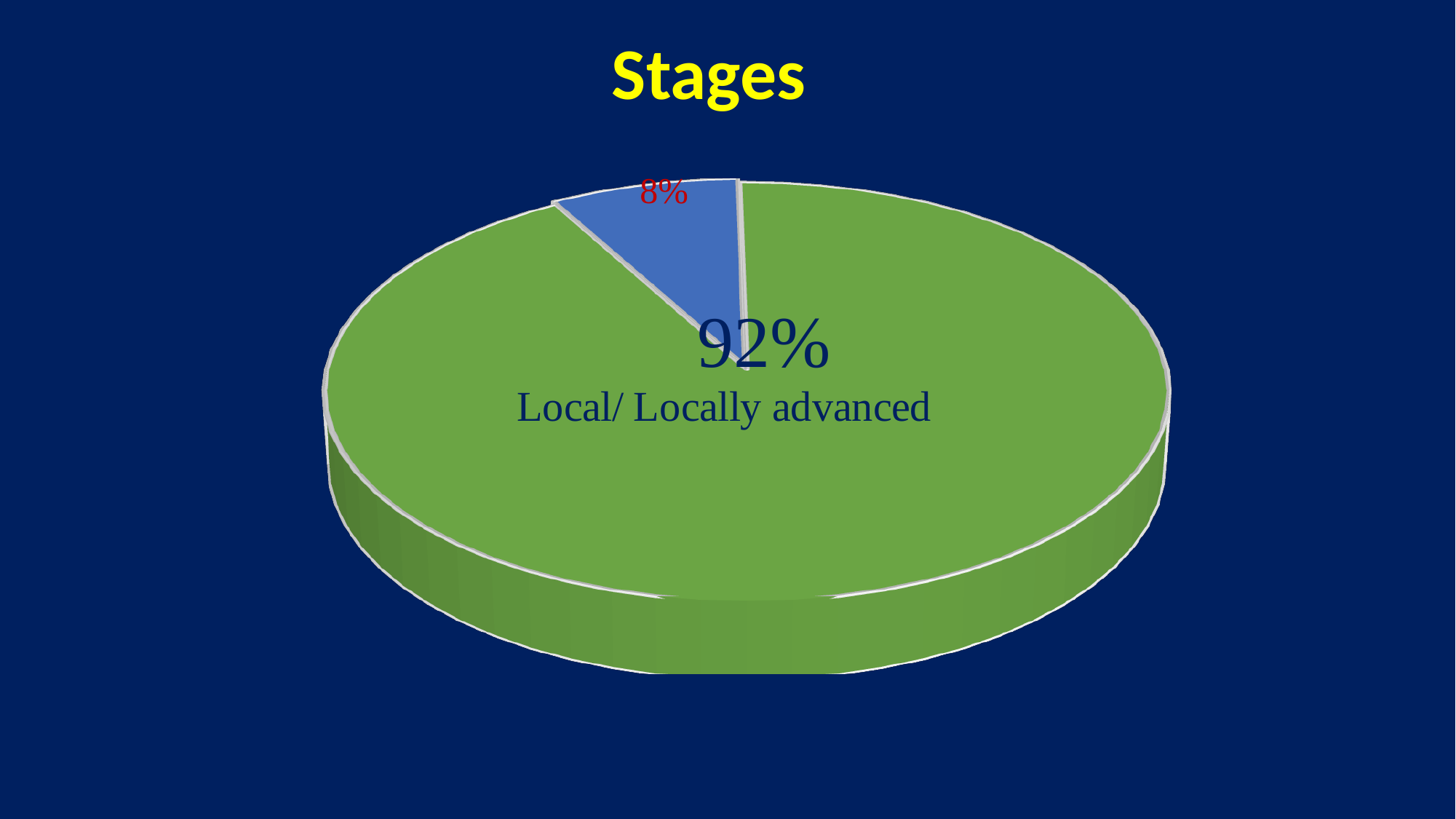
What is the difference in percentage points between the Local/ Locally advanced slice and the blue slice? 84 What is the total of the two percentages shown on the pie chart? 100% Is the Local/ Locally advanced slice larger or smaller than the blue slice? larger Which slice of the pie is the largest? Local/ Locally advanced What type of chart is shown on the slide? pie chart What is the title of the chart? Stages Which slice of the pie is the smallest, the green one or the blue one? the blue one How many slices does the pie chart have? 2 What percentage is shown on the blue slice of the pie? 8% What share of the pie does the Local/ Locally advanced slice represent? 92% What percentage is shown for Local/ Locally advanced? 92% What colour is the Local/ Locally advanced slice? green